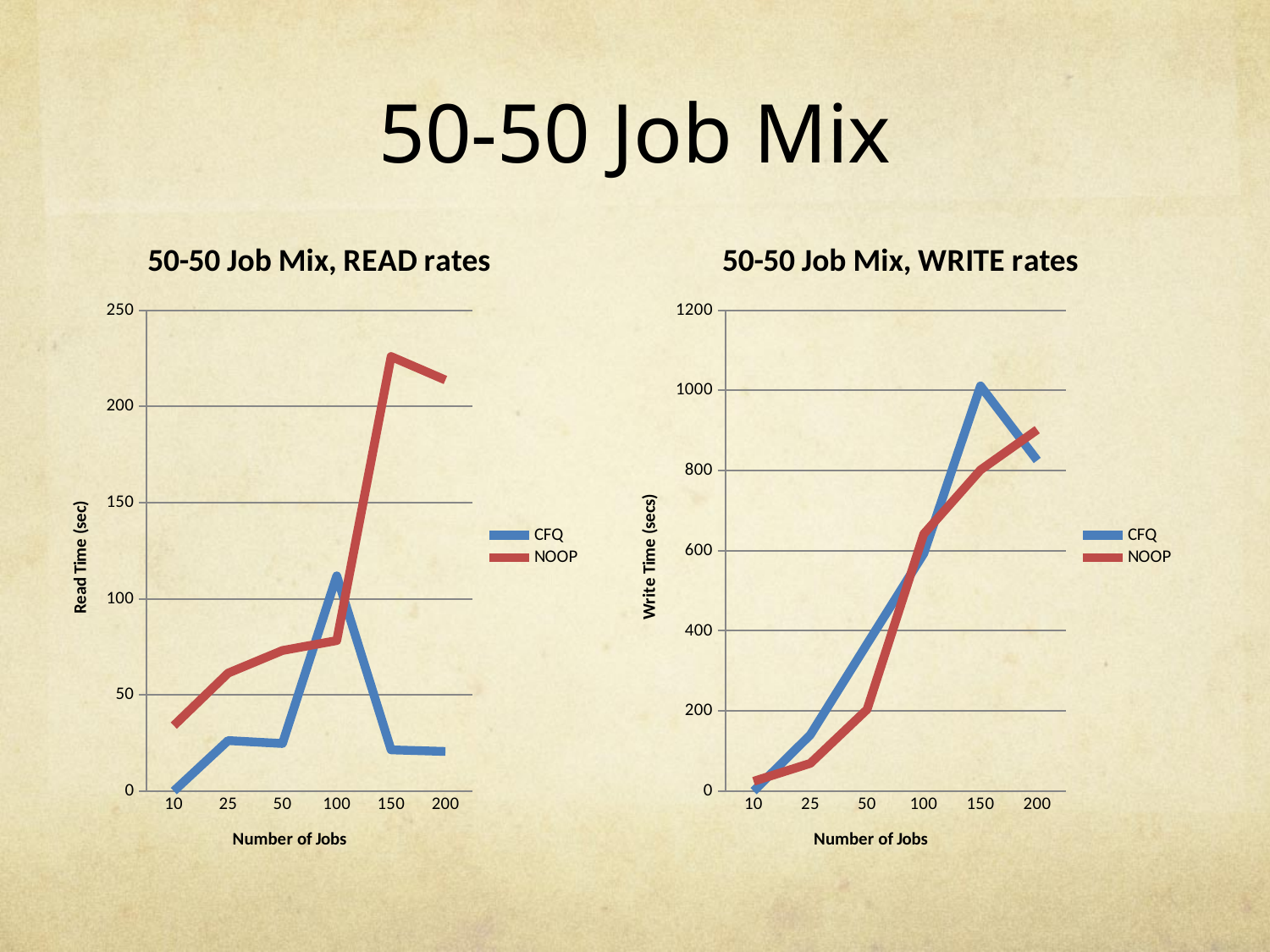
On the '50-50 Job Mix, WRITE rates' chart, is the NOOP value at 50 jobs greater or less than 400? less On the '50-50 Job Mix, WRITE rates' chart, does the NOOP write time rise or fall from 10 jobs to 200 jobs? rise On the '50-50 Job Mix, READ rates' chart, is the CFQ value at 150 jobs greater or less than 50? less On the '50-50 Job Mix, READ rates' chart, how many series does the legend list? 2 On the '50-50 Job Mix, READ rates' chart, is the NOOP value at 150 jobs greater or less than 200? greater On the '50-50 Job Mix, READ rates' chart, at which number of jobs is the NOOP read time highest? 150 On the '50-50 Job Mix, WRITE rates' chart, what is the label on the vertical axis? Write Time (secs) On the '50-50 Job Mix, WRITE rates' chart, at 200 jobs, which series has the higher write time, CFQ or NOOP? NOOP On the '50-50 Job Mix, WRITE rates' chart, how many Number of Jobs values are plotted along the x axis? 6 On the '50-50 Job Mix, READ rates' chart, at 100 jobs, which series has the higher read time, CFQ or NOOP? CFQ On the '50-50 Job Mix, READ rates' chart, what kind of chart is shown? line chart On the '50-50 Job Mix, WRITE rates' chart, at which number of jobs is the CFQ write time highest? 150